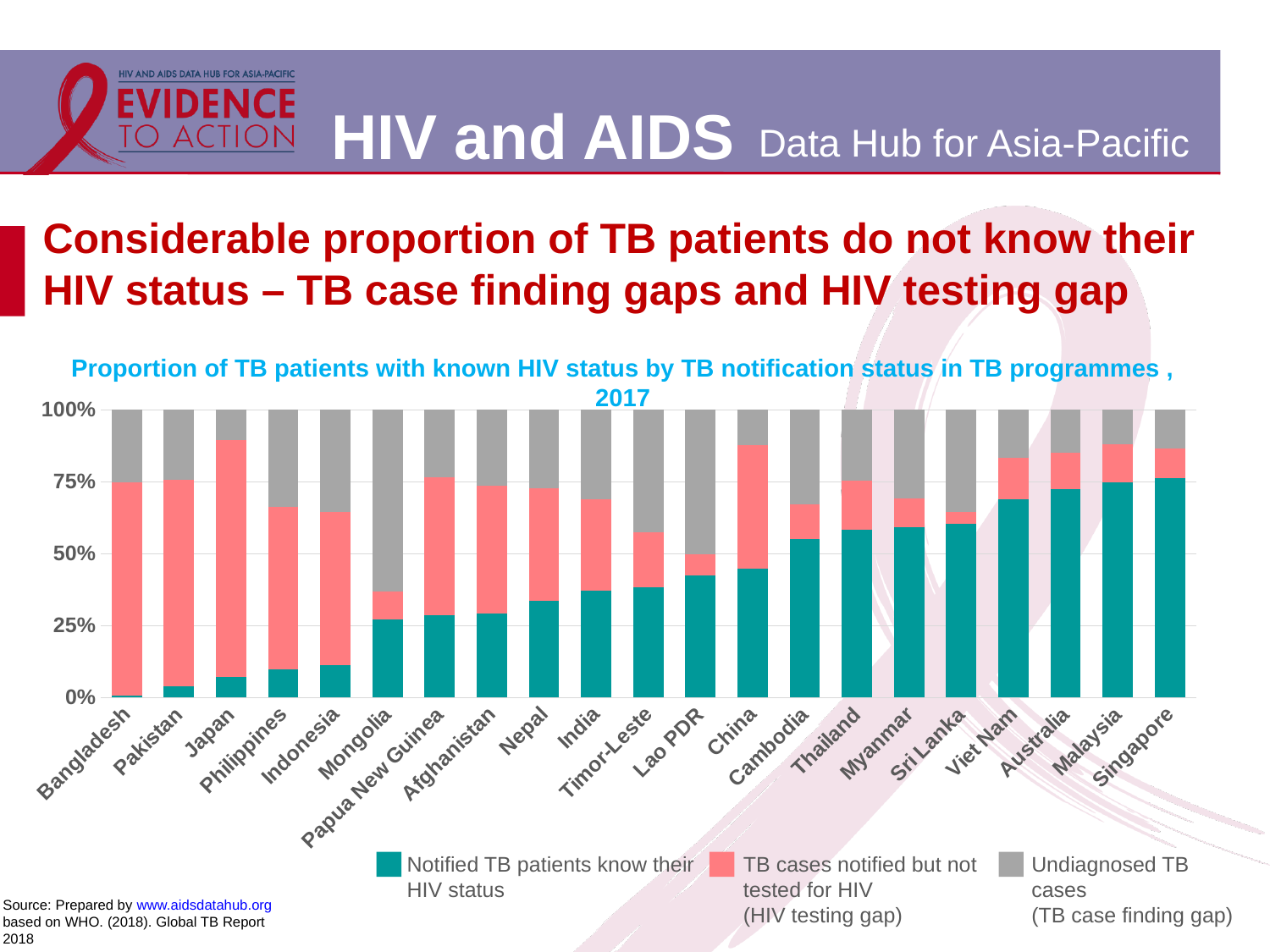
What kind of chart is shown on the slide? stacked bar chart Which colour represents undiagnosed TB cases (TB case finding gap) in the chart? grey Which country has the lowest proportion of notified TB patients who know their HIV status? Bangladesh Is the proportion of notified TB patients who know their HIV status in Japan greater or less than 25%? less How many series does the chart's legend list? 3 Which country has the largest share of undiagnosed TB cases (TB case finding gap)? Mongolia Is the proportion of notified TB patients who know their HIV status in Lao PDR greater or less than 50%? less Which country has the highest proportion of notified TB patients who know their HIV status? Singapore Which country has a larger proportion of notified TB patients who know their HIV status, Cambodia or India? Cambodia Moving from left to right along the x axis, does the proportion of notified TB patients who know their HIV status generally rise or fall? rise Is the proportion of notified TB patients who know their HIV status in Viet Nam greater or less than 75%? less How many countries are shown on the x axis of the chart? 21